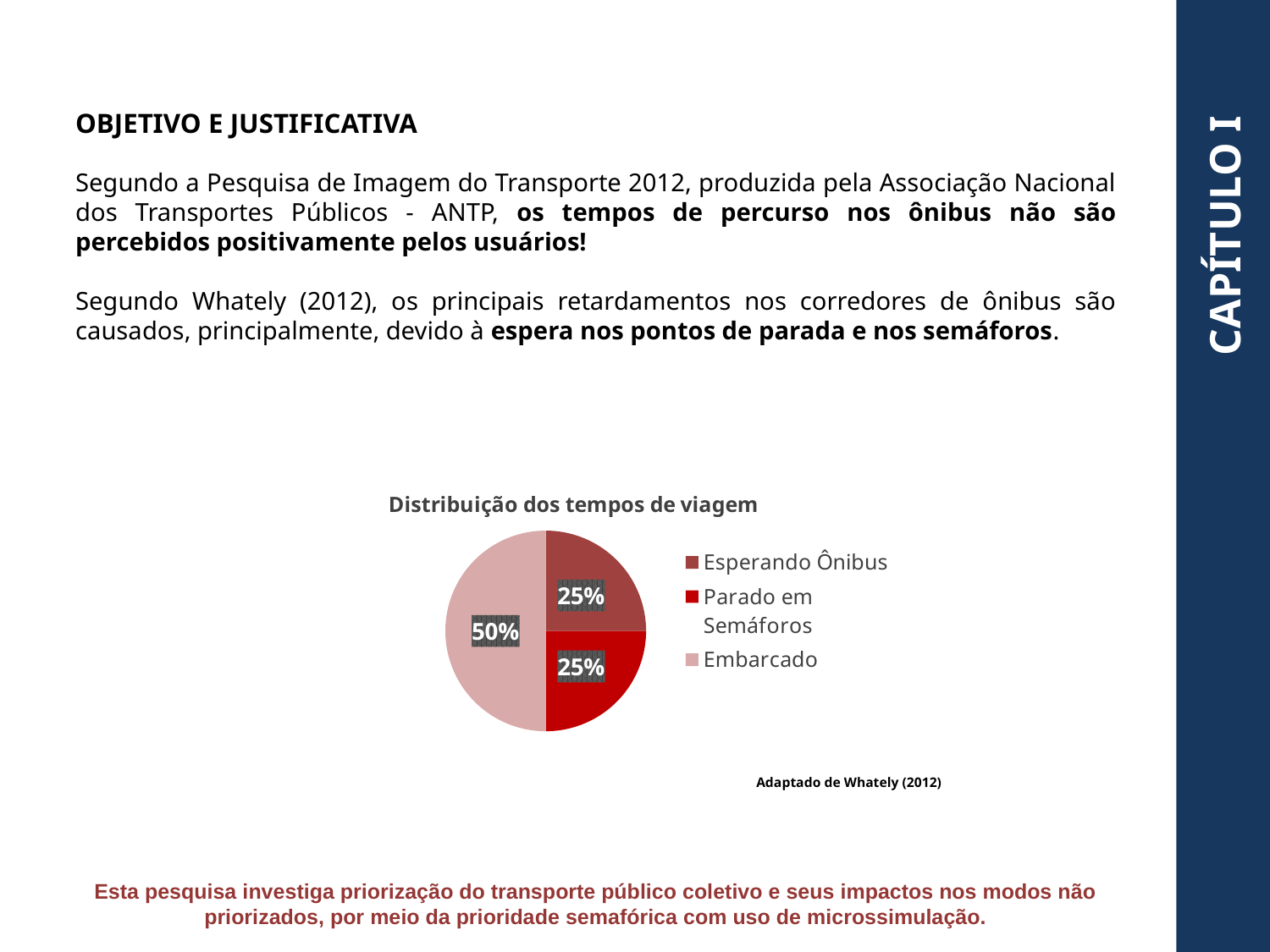
What is the difference between the Embarcado share and the Esperando Ônibus share? 25% What is the combined share of Esperando Ônibus and Parado em Semáforos? 50% What share of the pie is Parado em Semáforos? 25% Which is larger, the Embarcado slice or the Parado em Semáforos slice? Embarcado How many slices does the pie chart have? 3 How many entries does the legend list? 3 Which category has the largest slice of the pie? Embarcado What is the title of the chart? Distribuição dos tempos de viagem What share of the pie is Esperando Ônibus? 25% Which legend entry is shown in the lightest pink colour? Embarcado What share of the pie is Embarcado? 50% What kind of chart is shown on the slide? pie chart